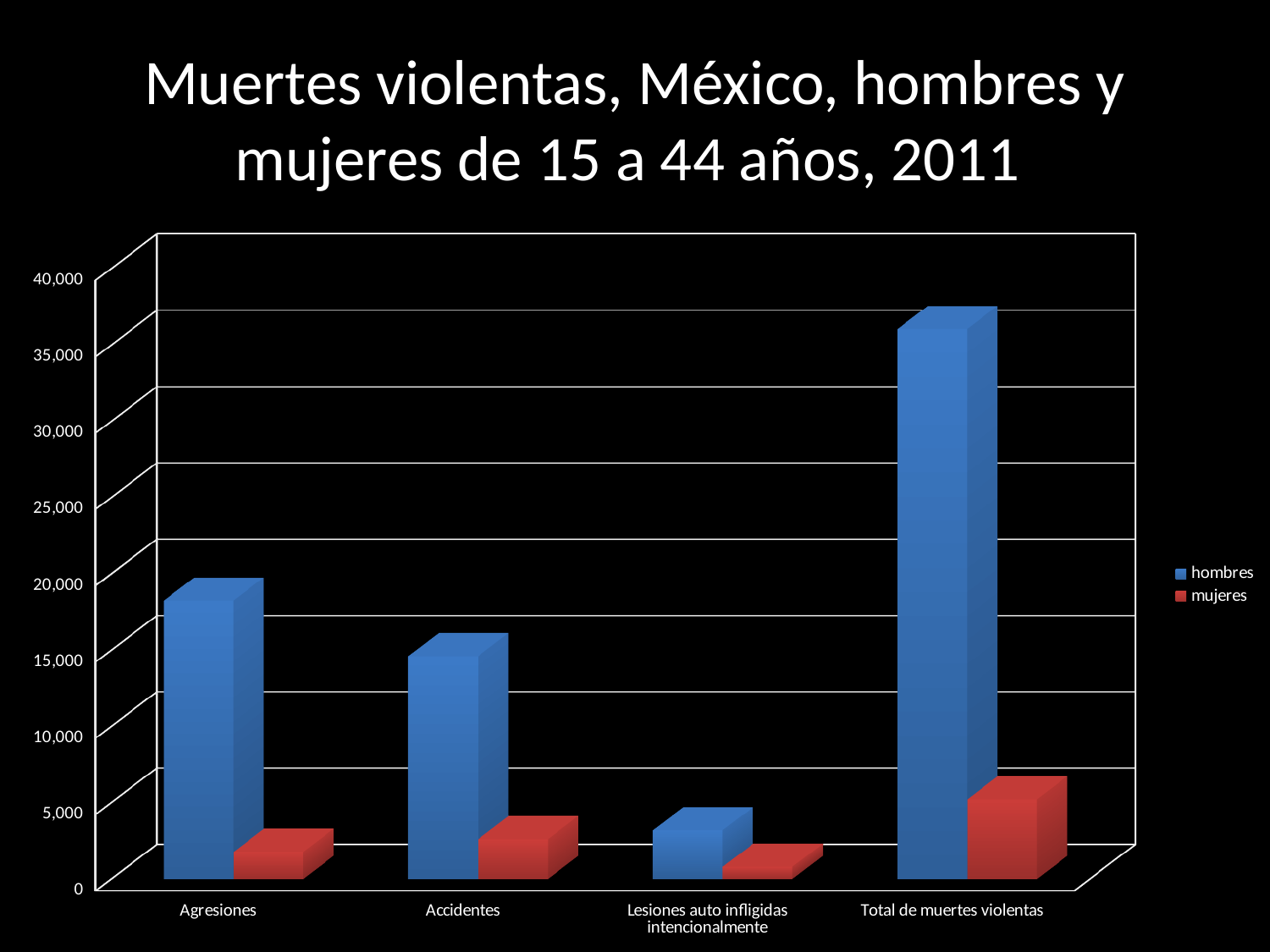
Is the value for mujeres in Total de muertes violentas greater or less than 10,000? less Which category has the highest value for hombres? Total de muertes violentas Which category has the lowest value for mujeres? Lesiones auto infligidas intencionalmente How many series does the legend list? 2 Is the value for hombres in Agresiones greater or less than 15,000? greater Is the value for hombres in Lesiones auto infligidas intencionalmente greater or less than 10,000? less How many categories are shown on the x axis of the chart? 4 In the Agresiones category, which series has the larger value, hombres or mujeres? hombres Which category has the lowest value for hombres? Lesiones auto infligidas intencionalmente What colour are the bars for the mujeres series? red What kind of chart is shown on the slide? bar chart